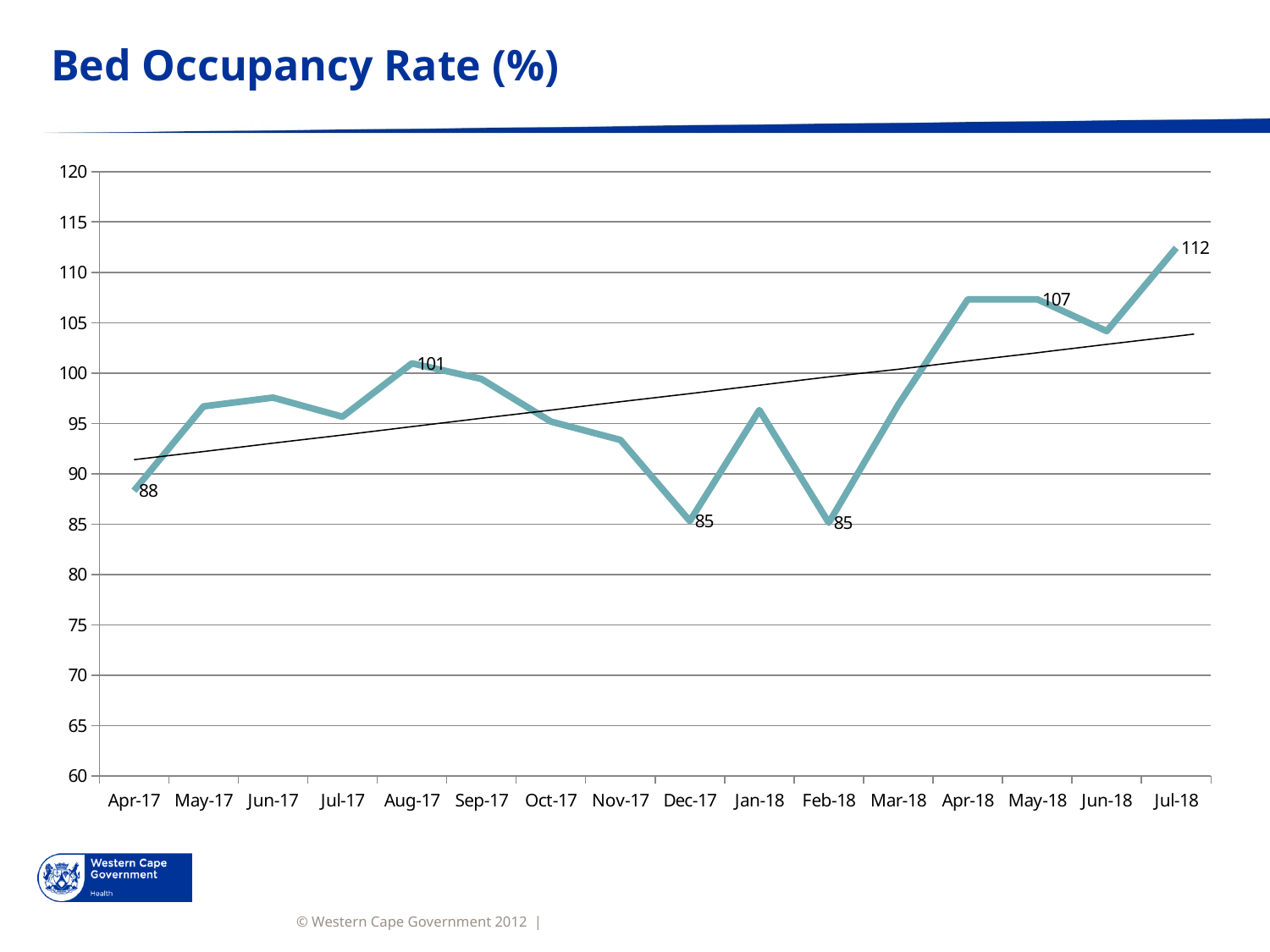
What is the bed occupancy rate for Aug-17? 101 What kind of chart is shown on the slide? line chart What is the difference between the bed occupancy rate in Jul-18 and in Apr-17? 24 What is the bed occupancy rate for May-18? 107 What is the bed occupancy rate for Apr-17? 88 How many months are plotted on the x axis? 16 Which month has the highest bed occupancy rate? Jul-18 Is the value for Apr-18 greater or less than 105? greater Is the value for Nov-17 greater or less than 95? less What is the difference between the bed occupancy rate in Aug-17 and in Dec-17? 16 What is the bed occupancy rate for Jul-18? 112 Which is larger, the bed occupancy rate in Aug-17 or in Apr-17? Aug-17